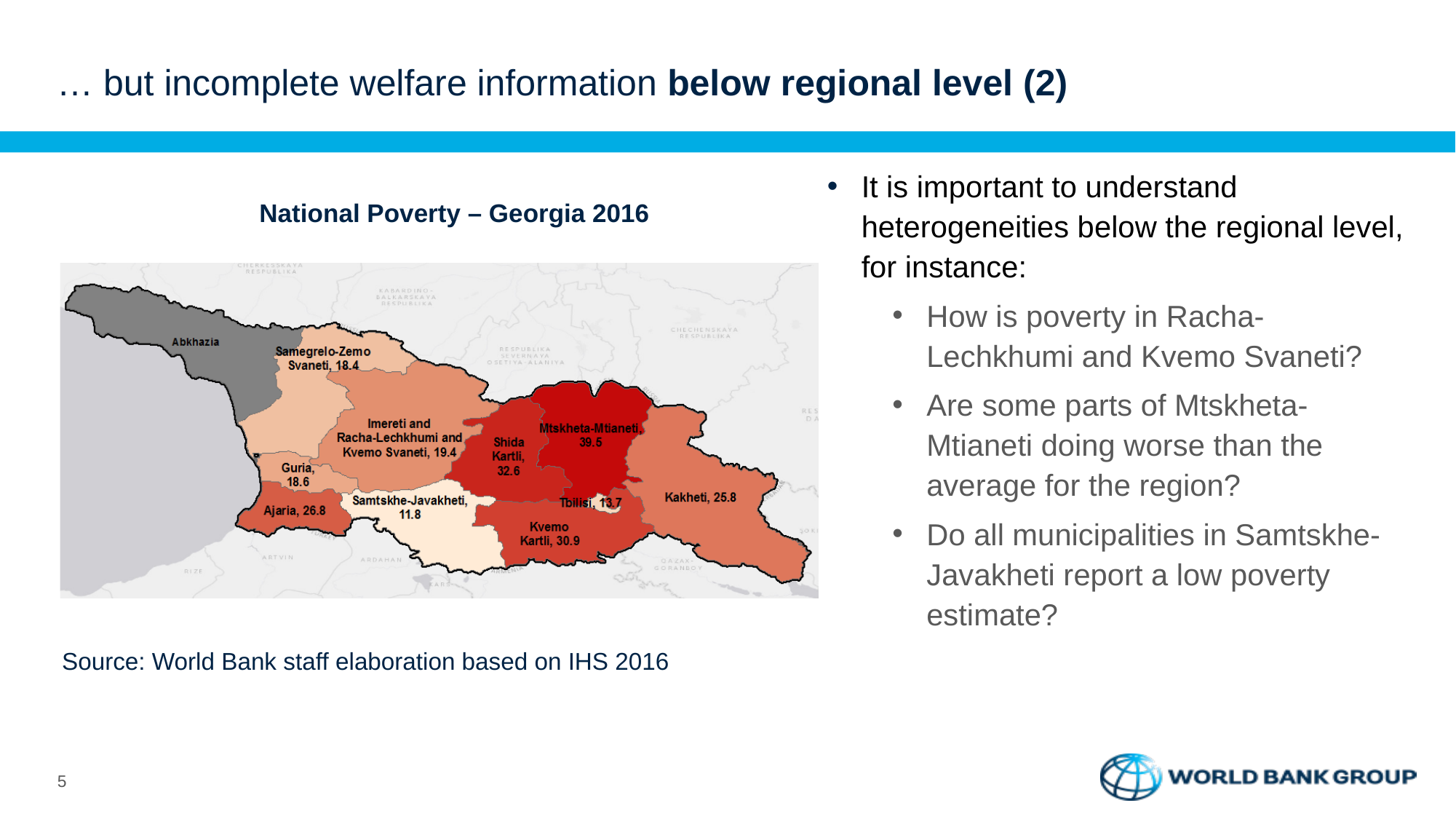
What is the poverty value shown for Samtskhe-Javakheti? 11.8 How many regions on the map have a poverty value printed? 10 What is the difference between the poverty values of Mtskheta-Mtianeti and Samtskhe-Javakheti? 27.7 Which has a higher poverty value, Ajaria or Kakheti? Ajaria What is the poverty value shown for Kvemo Kartli? 30.9 What is the title of the chart? National Poverty – Georgia 2016 Which region on the map is shaded grey with no poverty value shown? Abkhazia Which region on the map has the highest poverty value? Mtskheta-Mtianeti What kind of chart is shown on the slide? A map (choropleth map) What is the poverty value shown for Mtskheta-Mtianeti? 39.5 Which region on the map has the lowest poverty value? Samtskhe-Javakheti What is the poverty value shown for Tbilisi? 13.7